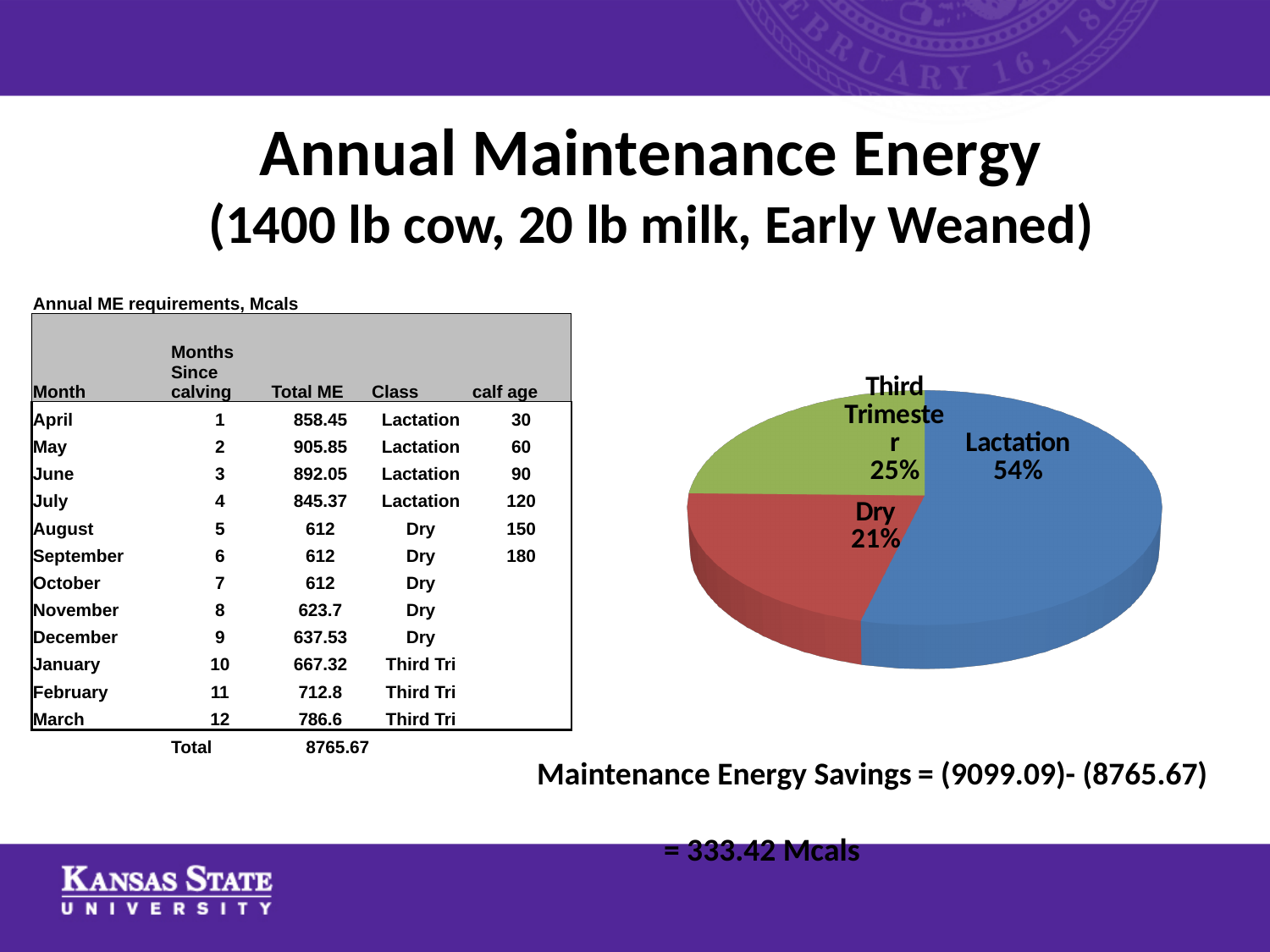
Which slice of the pie chart is the smallest? Dry What kind of chart is shown on the slide? pie chart Which is larger in the pie chart, Dry or Third Trimester? Third Trimester What colour is the Lactation slice of the pie chart? blue Which slice of the pie chart is the largest? Lactation What share of the pie does Lactation represent? 54% What share of the pie does Third Trimester represent? 25% What is the difference in percentage points between the Lactation and Dry slices? 33 What is the difference in percentage points between the Third Trimester and Dry slices? 4 How many slices does the pie chart have? 3 What colour is the Dry slice of the pie chart? red What share of the pie does Dry represent? 21%